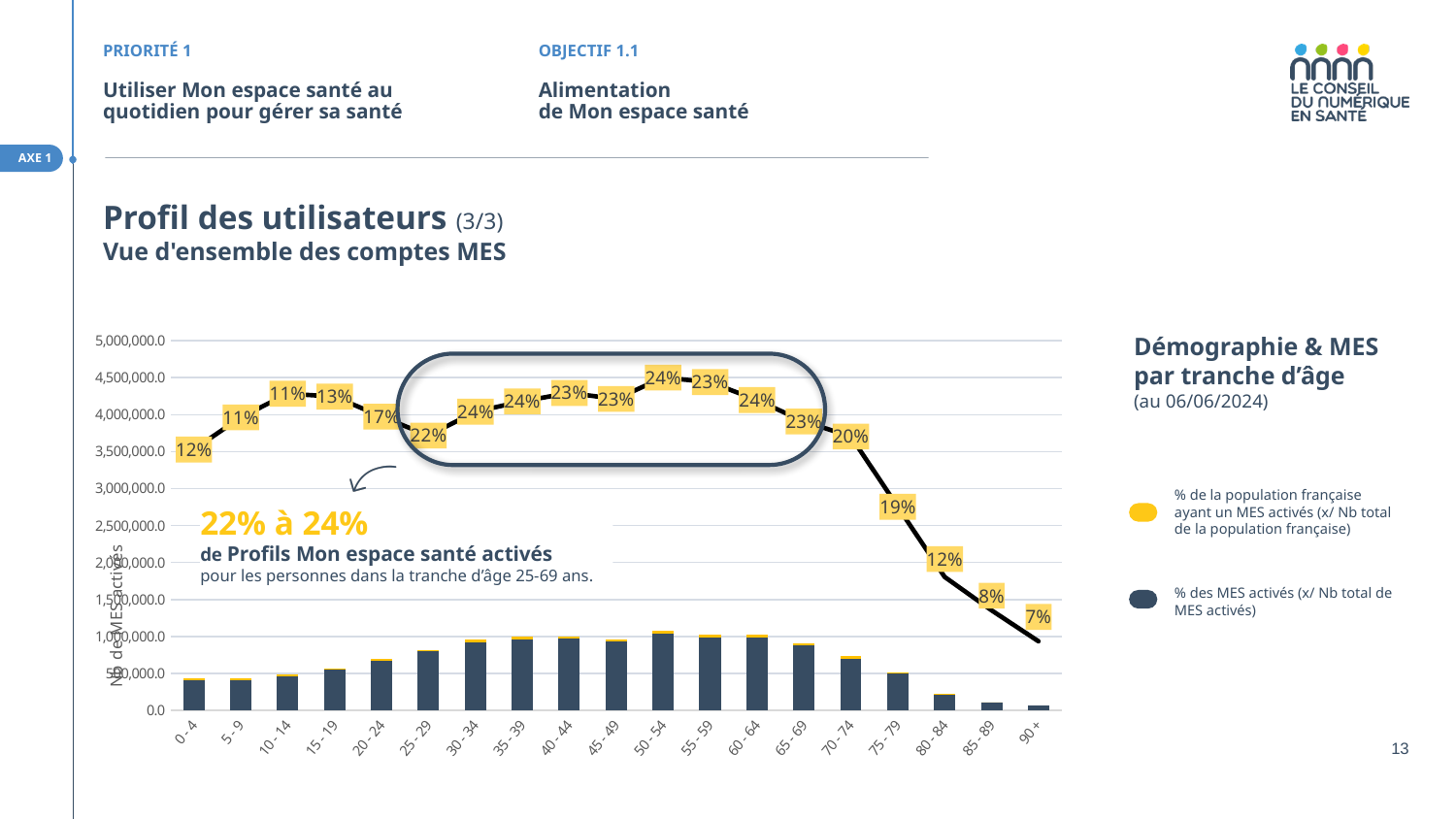
Is the bar for the 15 - 19 age group greater or less than 500,000? greater What percentage label is shown for the 0 - 4 age group? 12% How many series does the legend list? 2 What percentage label is shown for the 25 - 29 age group? 22% What percentage label is shown for the 75 - 79 age group? 19% Which age group has the lowest percentage label on the line? 90 + How many age groups are shown on the x axis? 19 Is the bar for the 80 - 84 age group greater or less than 500,000? less Do the percentage labels rise or fall from the 70 - 74 age group to the 90 + age group? fall What percentage label is shown for the 90 + age group? 7% Which age group has the higher percentage label, 20 - 24 or 25 - 29? 25 - 29 What is the difference between the percentage labels for the 30 - 34 and 90 + age groups? 17 percentage points